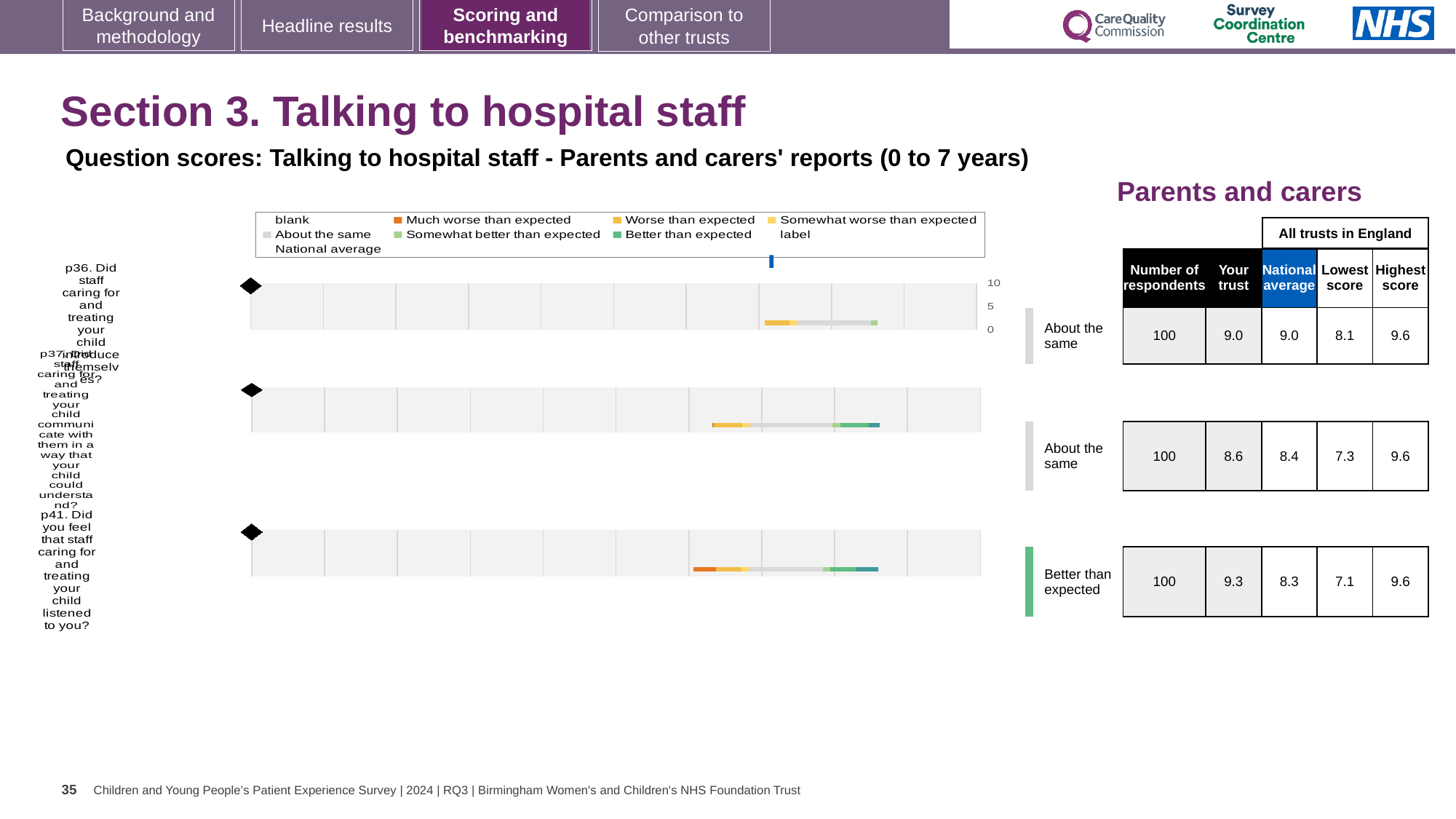
Which of the three questions has the lowest 'Your trust' score? p37 What is the national average score for p37 (Did staff communicate with your child in a way they could understand?)? 8.4 For p41, what is the difference between the 'Your trust' score and the national average? 1.0 What is the lowest score across all trusts in England for p41 (Did you feel that staff listened to you?)? 7.1 What is the 'Your trust' score for p36 (Did staff caring for and treating your child introduce themselves?)? 9.0 How many respondents answered p36? 100 For p36, what is the difference between the highest score and the lowest score across all trusts in England? 1.5 How many survey questions are plotted on this slide? 3 For p37, which is larger: the 'Your trust' score or the national average? Your trust What benchmark category is shown for p41 (Did you feel that staff listened to you?)? Better than expected Which of the three questions has the highest 'Your trust' score? p41 What is the highest score across all trusts in England for p37? 9.6